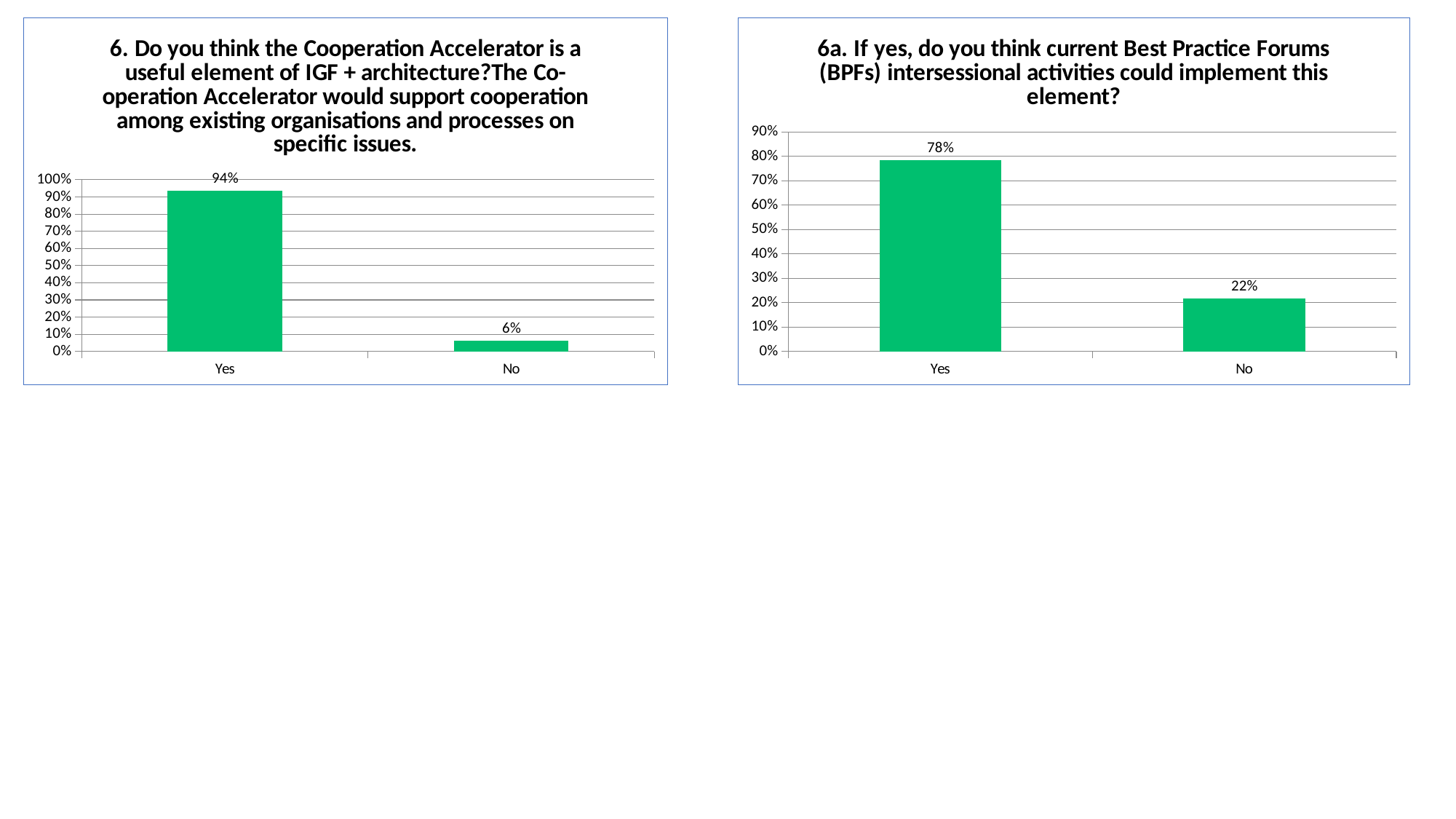
In the left chart (question 6), which category has the highest value? Yes In the left chart (question 6), what is the difference between the Yes and No values? 88% In the right chart (question 6a, Best Practice Forums), what is the value for Yes? 78% Is the Yes value in the left chart (question 6) larger or smaller than the Yes value in the right chart (question 6a)? larger In the right chart (question 6a, Best Practice Forums), what is the value for No? 22% How many categories are shown in the right chart (question 6a)? 2 What is the highest value shown on the vertical axis of the right chart (question 6a)? 90% What kind of chart is the left chart (question 6)? bar chart In the left chart (question 6, Cooperation Accelerator), what is the value for No? 6% In the left chart (question 6, Cooperation Accelerator), what is the value for Yes? 94% In the right chart (question 6a), what is the difference between the Yes and No values? 56% In the right chart (question 6a), which category has the lowest value? No